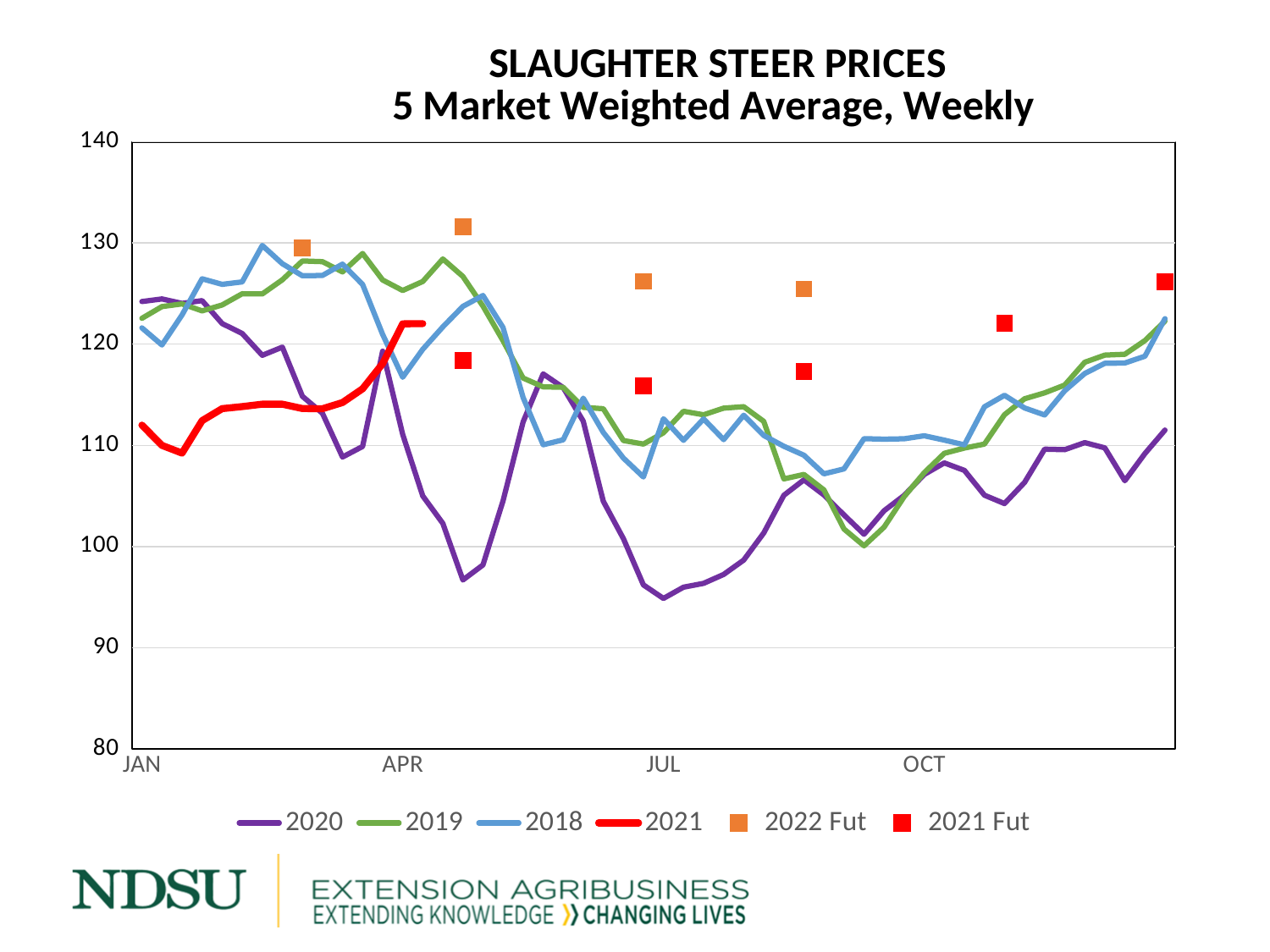
What is the title of the chart? SLAUGHTER STEER PRICES 5 Market Weighted Average, Weekly Is the 2021 Fut point plotted near JUL greater or less than 120? less At JUL, which line is higher, 2019 or 2020? 2019 What kind of chart is shown on the slide? line chart How many series does the legend list? 6 Is the value of the 2020 line at JUL greater or less than 100? less What colour is the 2021 line in the chart? red Are the 2022 Fut points plotted above or below the 2021 Fut points? above Is the highest 2022 Fut point greater or less than 130? greater Does the 2021 line rise or fall overall from JAN to APR? rise